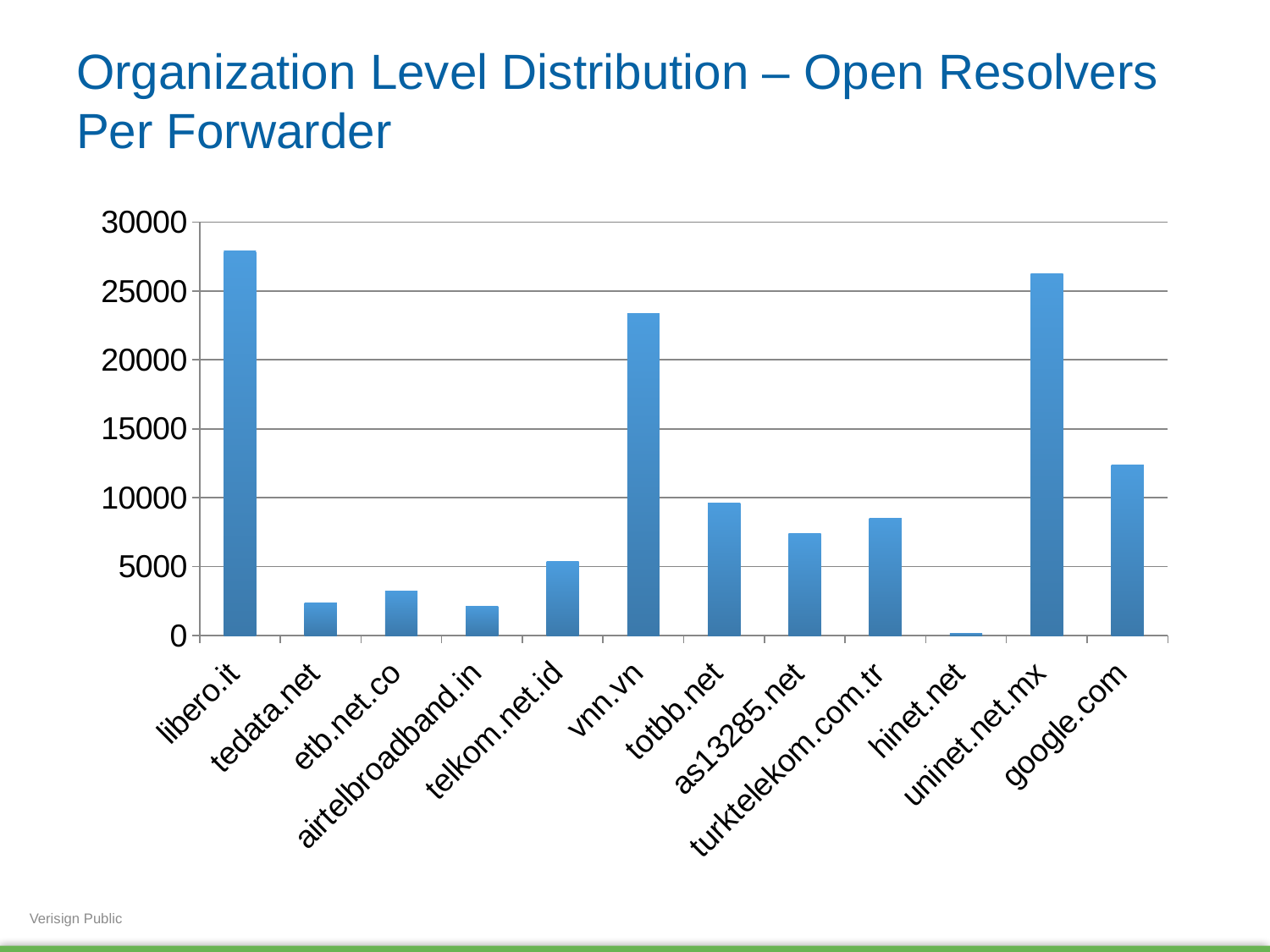
Which organization has the highest number of open resolvers per forwarder? libero.it Is the value for google.com greater or less than 10000? greater How many organizations (categories) are shown on the x axis of the chart? 12 Is the value for as13285.net greater or less than 10000? less Is the value for tedata.net greater or less than 5000? less Which has a higher value, totbb.net or as13285.net? totbb.net Which has a higher value, vnn.vn or google.com? vnn.vn Which organization has the lowest number of open resolvers per forwarder? hinet.net What kind of chart is shown on the slide? bar chart What is the title of the slide containing the chart? Organization Level Distribution – Open Resolvers Per Forwarder